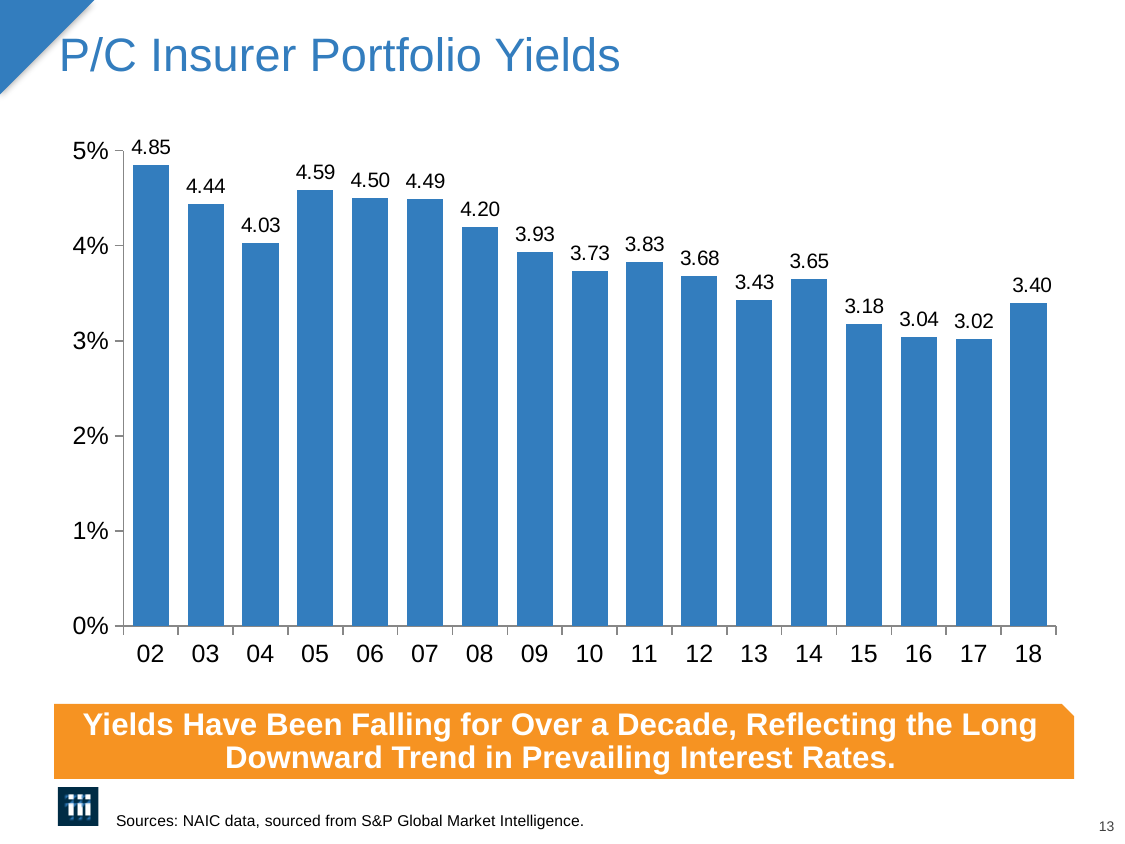
What is the title of the chart? P/C Insurer Portfolio Yields Which is larger, the yield for 10 or the yield for 11? 11 Which year has the lowest portfolio yield? 17 What is the portfolio yield value shown for 13? 3.43 What is the portfolio yield value shown for 02? 4.85 Which year has the highest portfolio yield? 02 Is the value for 08 greater or less than 4%? greater What kind of chart is shown on the slide? bar chart How many years are shown on the x axis? 17 Do the yields generally rise or fall from 02 to 18? fall What is the portfolio yield value shown for 18? 3.40 What is the difference between the yield in 02 and the yield in 18? 1.45